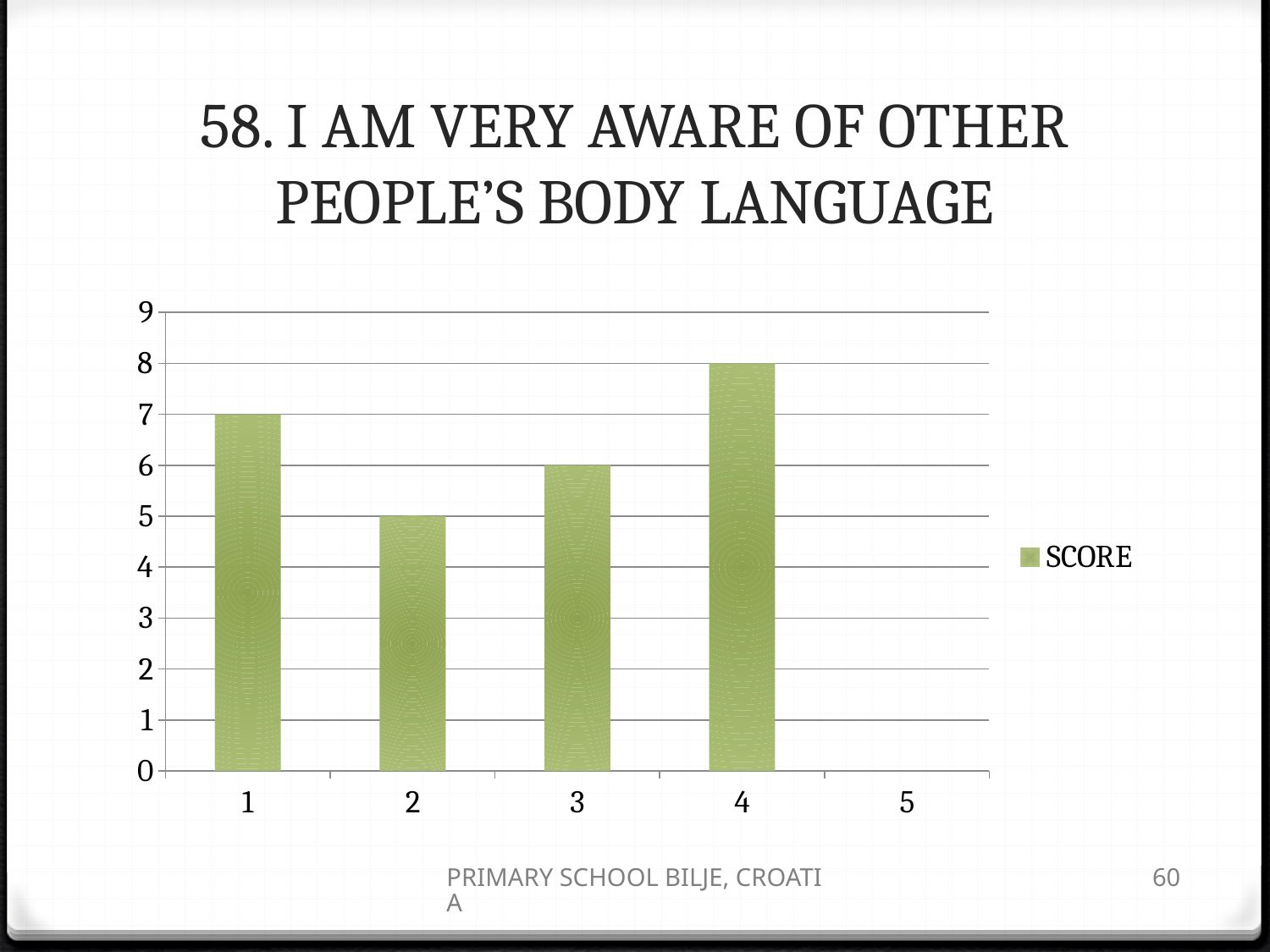
What is the SCORE value for category 1? 7 Which category has the highest SCORE? 4 Which category has the shortest visible bar? 2 What is the SCORE value for category 4? 8 What is the SCORE value for category 3? 6 How many series does the legend list? 1 What is the difference between the SCORE for category 4 and the SCORE for category 2? 3 What is the SCORE value for category 2? 5 How many categories are shown on the x axis? 5 What kind of chart is shown on the slide? bar chart Which has a larger SCORE, category 1 or category 3? category 1 Is the SCORE for category 4 greater or less than 7? greater